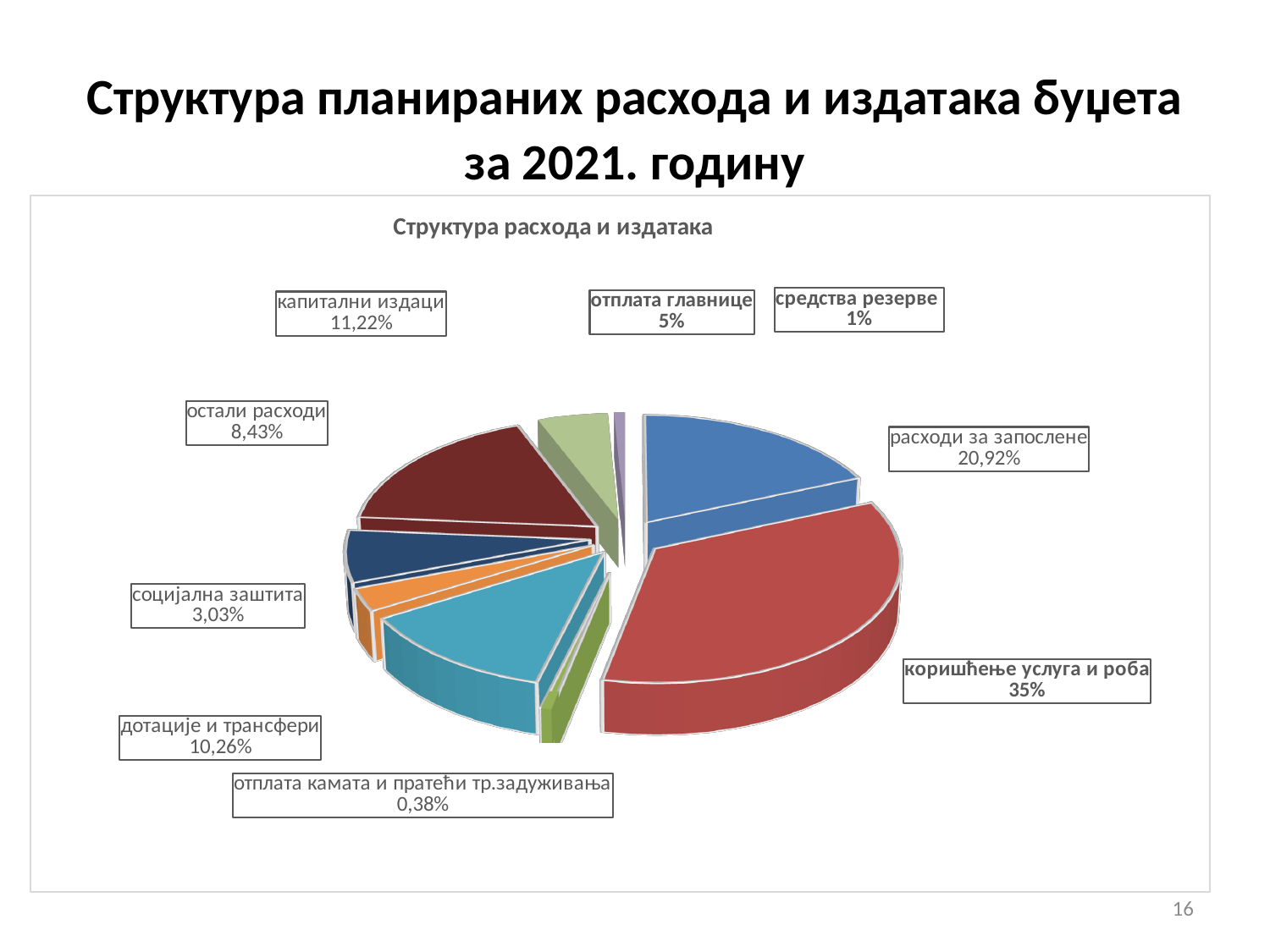
What share of the pie is labelled for коришћење услуга и роба? 35% What is the value shown for отплата камата и пратећи тр.задуживања? 0,38% Which category has the smallest share of the pie? отплата камата и пратећи тр.задуживања What is the title of the chart? Структура расхода и издатака What is the difference between the shares for коришћење услуга и роба and отплата главнице? 30% What is the value shown for капитални издаци? 11,22% What is the value shown for расходи за запослене? 20,92% Which is larger, the share for остали расходи or the share for социјална заштита? остали расходи What kind of chart is shown on the slide? pie chart How many slices does the pie chart have? 9 Which category has the largest share of the pie? коришћење услуга и роба What is the value shown for дотације и трансфери? 10,26%